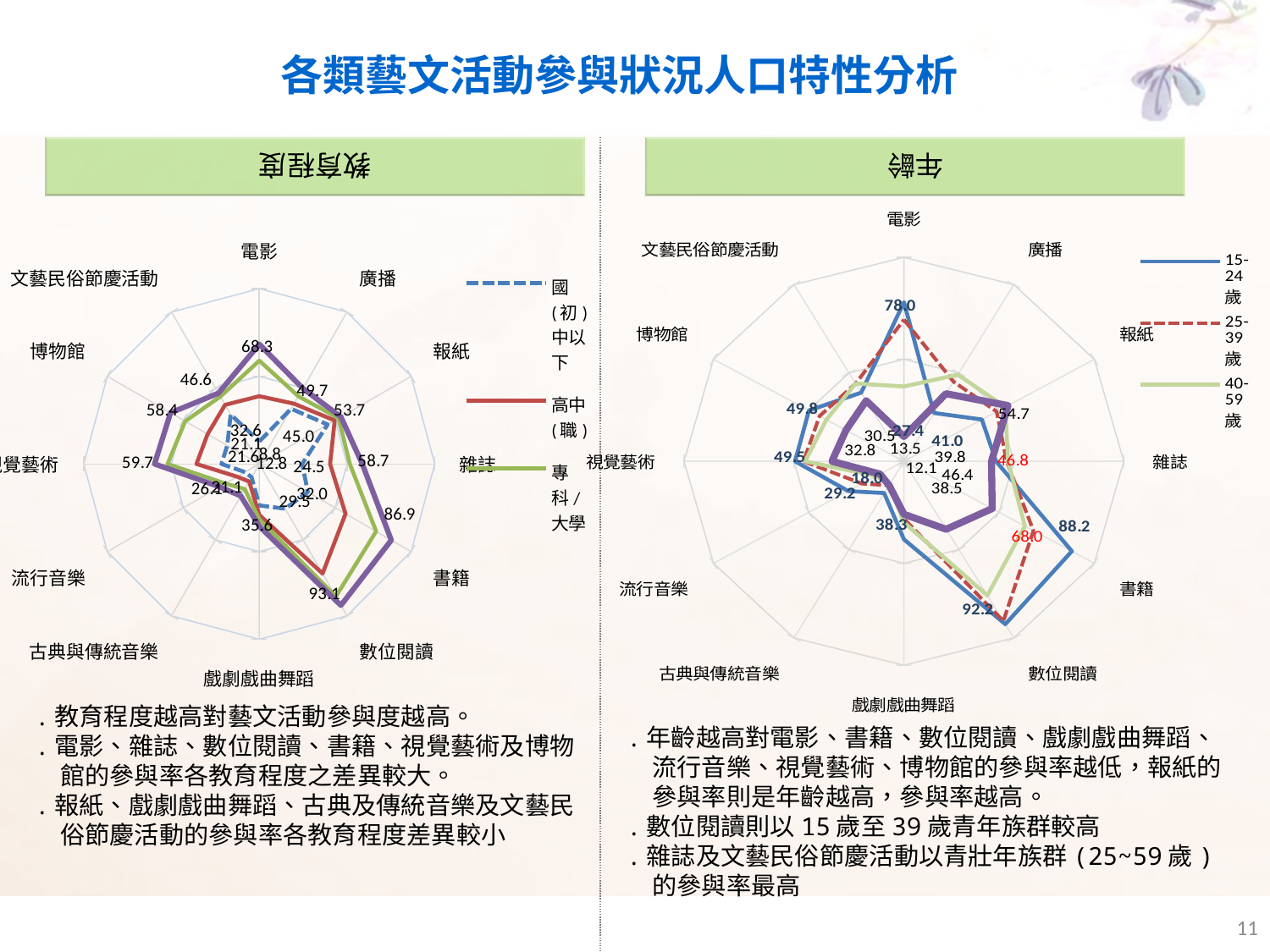
In the right-hand chart (年齡), what is the value for 數位閱讀 for the 15-24歲 group? 92.2 In the right-hand chart (年齡), what is the value for 書籍 for the 25-39歲 group? 68.0 What kind of chart is used on the left side of the slide (教育程度)? radar chart In the right-hand chart (年齡), what is the difference between the 15-24歲 and 25-39歲 values for 書籍? 20.2 In the right-hand chart (年齡), which group has the larger value for 書籍: 15-24歲 or 25-39歲? 15-24歲 How many age groups does the legend of the right-hand chart (年齡) list? 3 In the right-hand chart (年齡), what is the value for 書籍 for the 15-24歲 group? 88.2 In the left-hand chart (教育程度), what is the value labelled at 數位閱讀? 93.1 In the right-hand chart (年齡), which category has the highest value for the 15-24歲 group? 數位閱讀 How many activity categories are plotted around the right-hand radar chart (年齡)? 12 In the right-hand chart (年齡), what is the value for 電影 for the 15-24歲 group? 78.0 What are the three legend entries shown for the left-hand chart (教育程度)? 國(初)中以下, 高中(職), 專科/大學